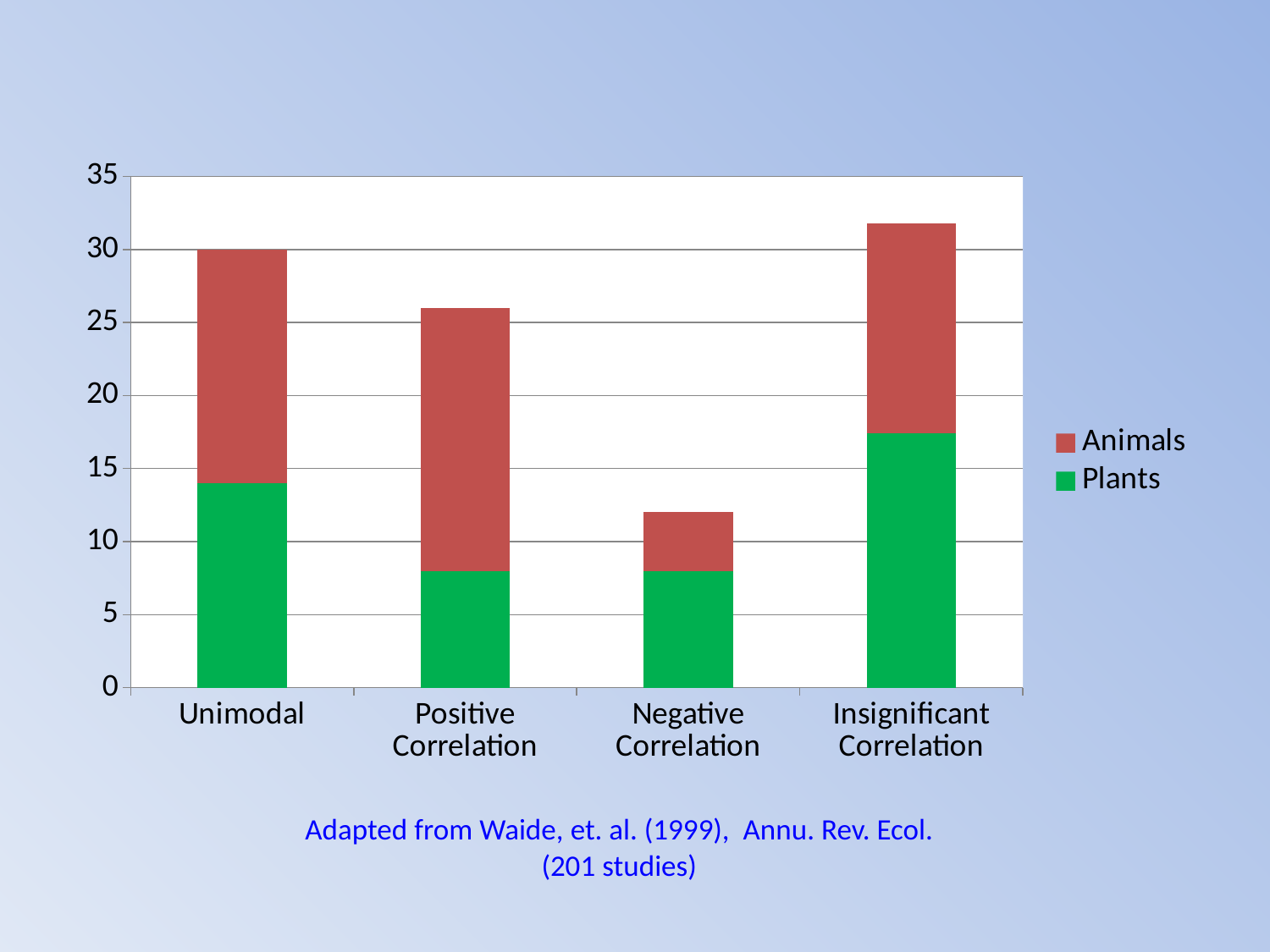
Which category has the tallest stacked bar overall? Insignificant Correlation What colour represents the Plants series in the chart? green How many series does the chart's legend list? 2 Is the total for Negative Correlation greater or less than 15? less Is the total for Insignificant Correlation greater or less than 30? greater How many categories are shown on the x axis of the chart? 4 Which is larger, the total for Unimodal or the total for Positive Correlation? Unimodal Which category has the largest Plants segment? Insignificant Correlation What kind of chart is shown on the slide? bar chart What is the total height of the stacked bar for Unimodal? 30 Is the Plants value for Insignificant Correlation greater or less than 15? greater Which category has the shortest stacked bar overall? Negative Correlation